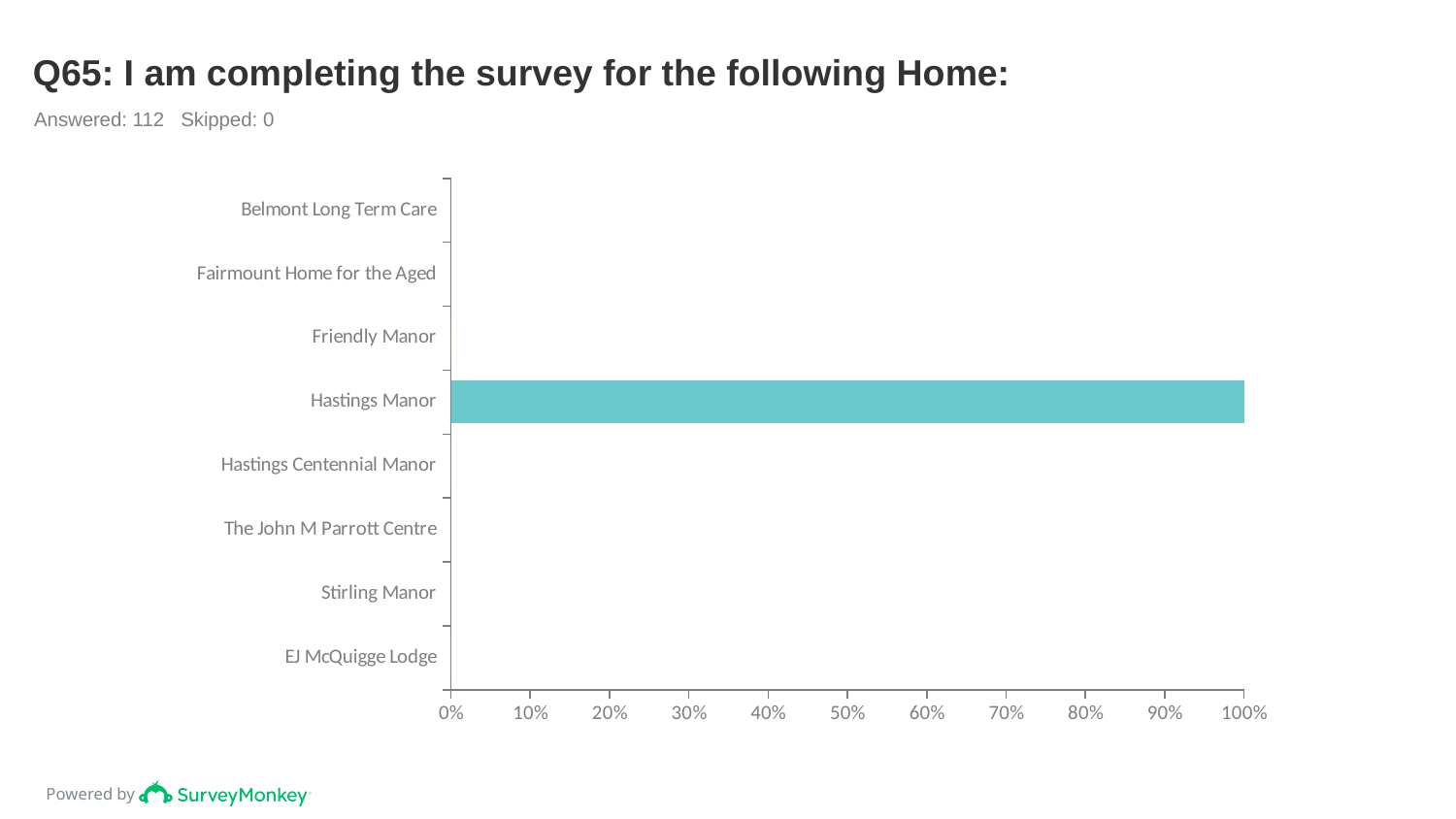
Is the value for Hastings Manor greater or less than 50%? greater What is the value for EJ McQuigge Lodge? 0% Is the value for Stirling Manor greater or less than 10%? less Which home has the highest value in the chart? Hastings Manor What is the maximum value shown on the horizontal axis? 100% How many respondents answered the question according to the slide? 112 How many homes are listed as categories in the chart? 8 What is the value for Hastings Manor? 100% What is the difference between the value for Hastings Manor and the value for Belmont Long Term Care? 100% Which is larger, the value for Hastings Manor or the value for Friendly Manor? Hastings Manor What is the title of the chart? Q65: I am completing the survey for the following Home: What kind of chart is shown on the slide? bar chart